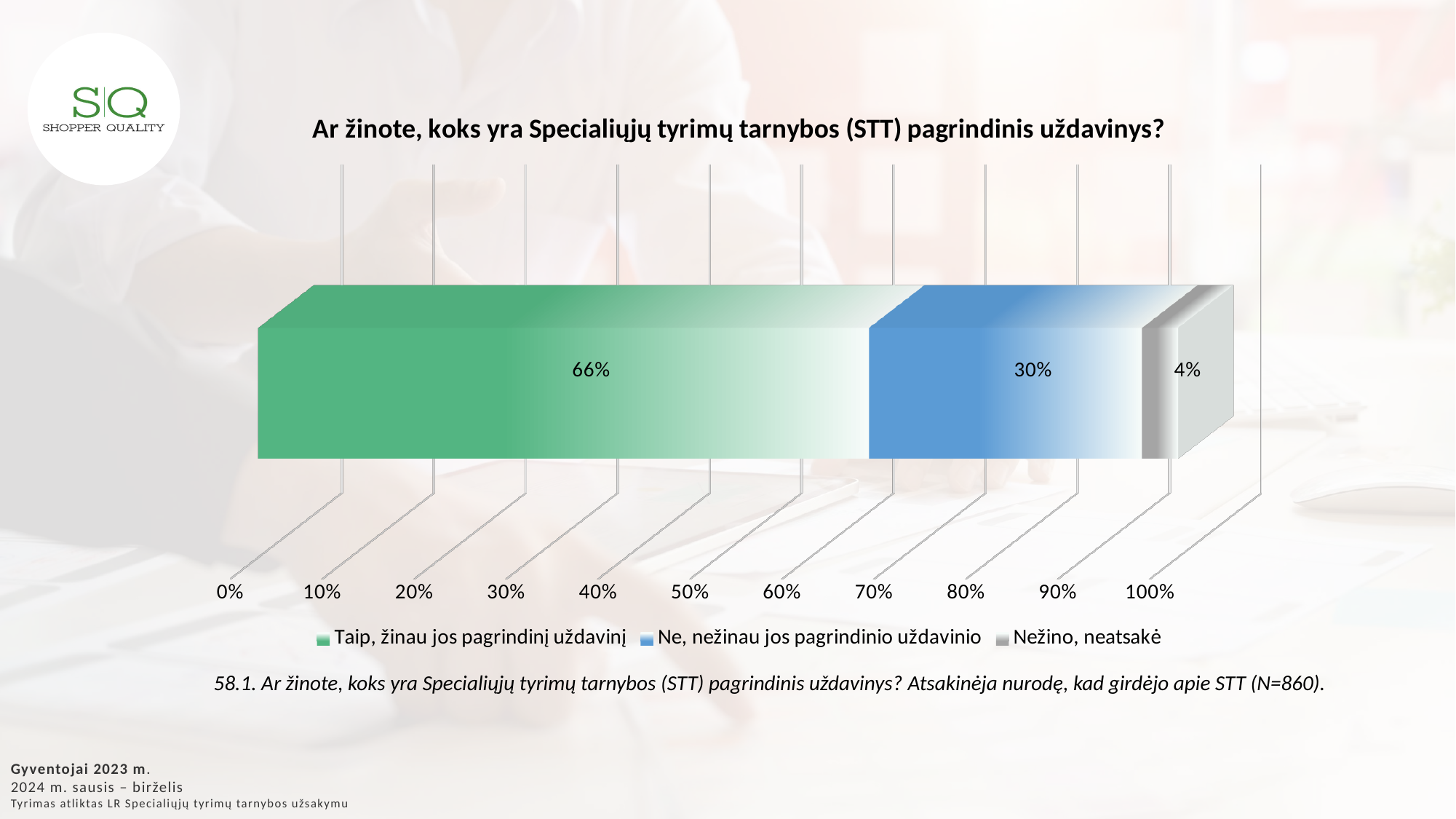
What percentage of respondents answered "Taip, žinau jos pagrindinį uždavinį"? 66% Which response category has the smallest share? Nežino, neatsakė What kind of chart is shown on the slide? Stacked bar chart What percentage of respondents fall under "Nežino, neatsakė"? 4% What is the difference in percentage points between "Taip, žinau jos pagrindinį uždavinį" and "Ne, nežinau jos pagrindinio uždavinio"? 36% Which response category has the largest share? Taip, žinau jos pagrindinį uždavinį What is the total of the stacked bar? 100% What percentage of respondents answered "Ne, nežinau jos pagrindinio uždavinio"? 30% Is the value for "Taip, žinau jos pagrindinį uždavinį" greater or less than 50%? greater How many series does the legend list? 3 What is the title of the chart? Ar žinote, koks yra Specialiųjų tyrimų tarnybos (STT) pagrindinis uždavinys? Which is larger: the share for "Ne, nežinau jos pagrindinio uždavinio" or for "Nežino, neatsakė"? Ne, nežinau jos pagrindinio uždavinio